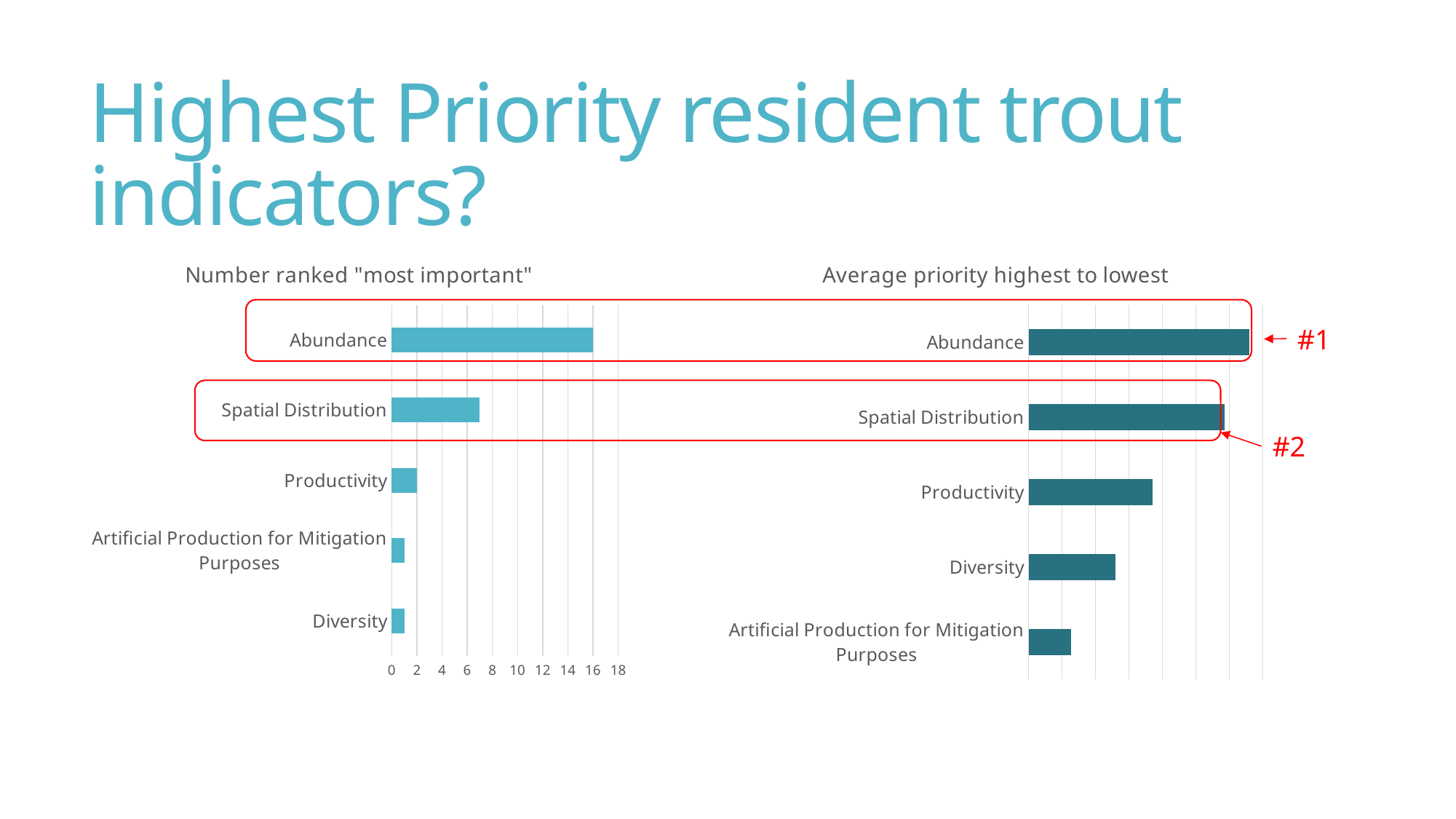
In the "Number ranked "most important"" chart, what is the value for Abundance? 16 In the "Number ranked "most important"" chart, which category has the highest value? Abundance In the "Number ranked "most important"" chart, is the value for Spatial Distribution greater or less than 6? greater What is the highest value shown on the x axis of the "Number ranked "most important"" chart? 18 In the "Average priority highest to lowest" chart, which category has the lowest value? Artificial Production for Mitigation Purposes In the "Average priority highest to lowest" chart, which is larger, Productivity or Diversity? Productivity In the "Number ranked "most important"" chart, is the value for Diversity greater or less than 2? less What type of chart is the "Number ranked "most important"" chart on the left? bar chart In the "Number ranked "most important"" chart, what is the difference between the values for Abundance and Productivity? 14 In the "Number ranked "most important"" chart, what is the value for Productivity? 2 How many categories are shown in the "Number ranked "most important"" chart? 5 In the "Average priority highest to lowest" chart, which category is marked as #1? Abundance